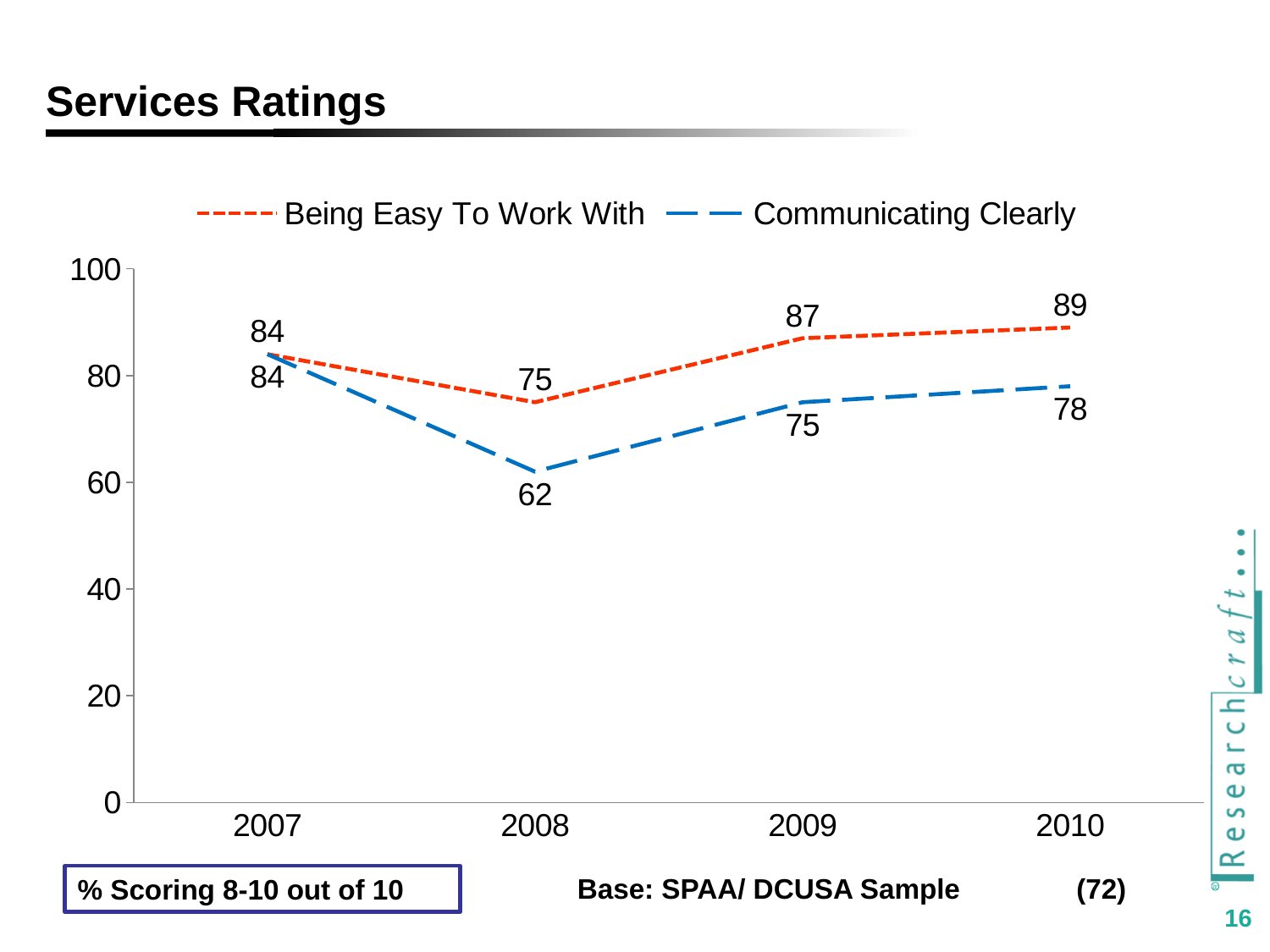
In which year is Being Easy To Work With highest? 2010 Is the value for Communicating Clearly in 2008 greater or less than 80? less What is the difference between Being Easy To Work With and Communicating Clearly in 2008? 13 What is the value for Being Easy To Work With in 2009? 87 Which series has the higher value in 2009, Being Easy To Work With or Communicating Clearly? Being Easy To Work With What kind of chart is shown on the slide? line chart How many series does the legend list? 2 Does Being Easy To Work With rise or fall from 2008 to 2010? rise How many years are shown on the x axis? 4 What is the value for Communicating Clearly in 2010? 78 What is the value for Communicating Clearly in 2008? 62 In which year is Communicating Clearly lowest? 2008